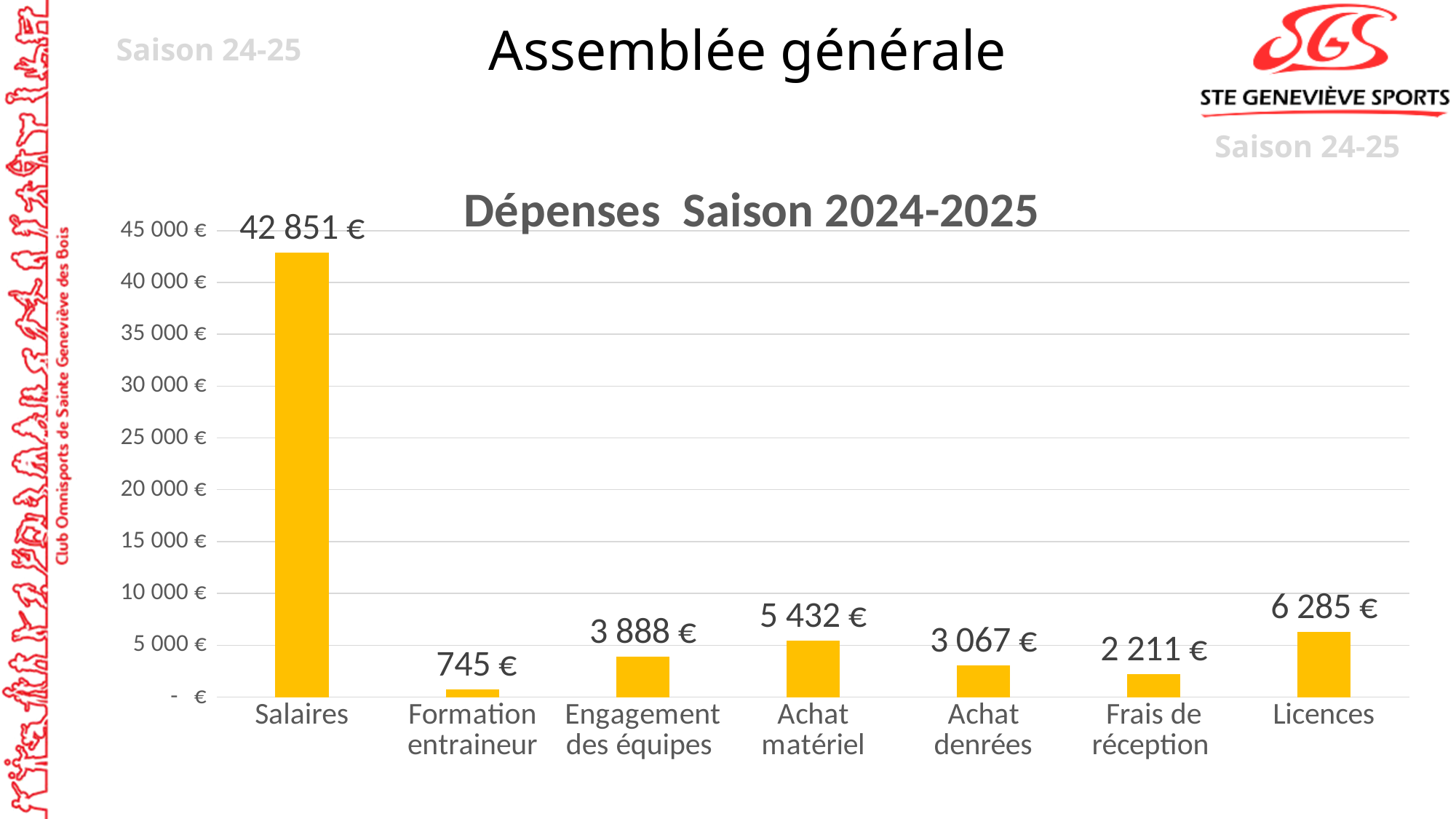
What kind of chart is shown? bar chart What is the title of the chart? Dépenses Saison 2024-2025 Is the value for Licences greater or less than 5 000 €? greater What is the value for Licences? 6 285 € Which category has the highest value? Salaires What is the difference between Achat matériel and Achat denrées? 2 365 € What is the difference between Salaires and Licences? 36 566 € What is the value for Salaires? 42 851 € Which category has the lowest value? Formation entraineur What is the value for Formation entraineur? 745 € Which is larger, Engagement des équipes or Frais de réception? Engagement des équipes How many categories are shown on the chart? 7